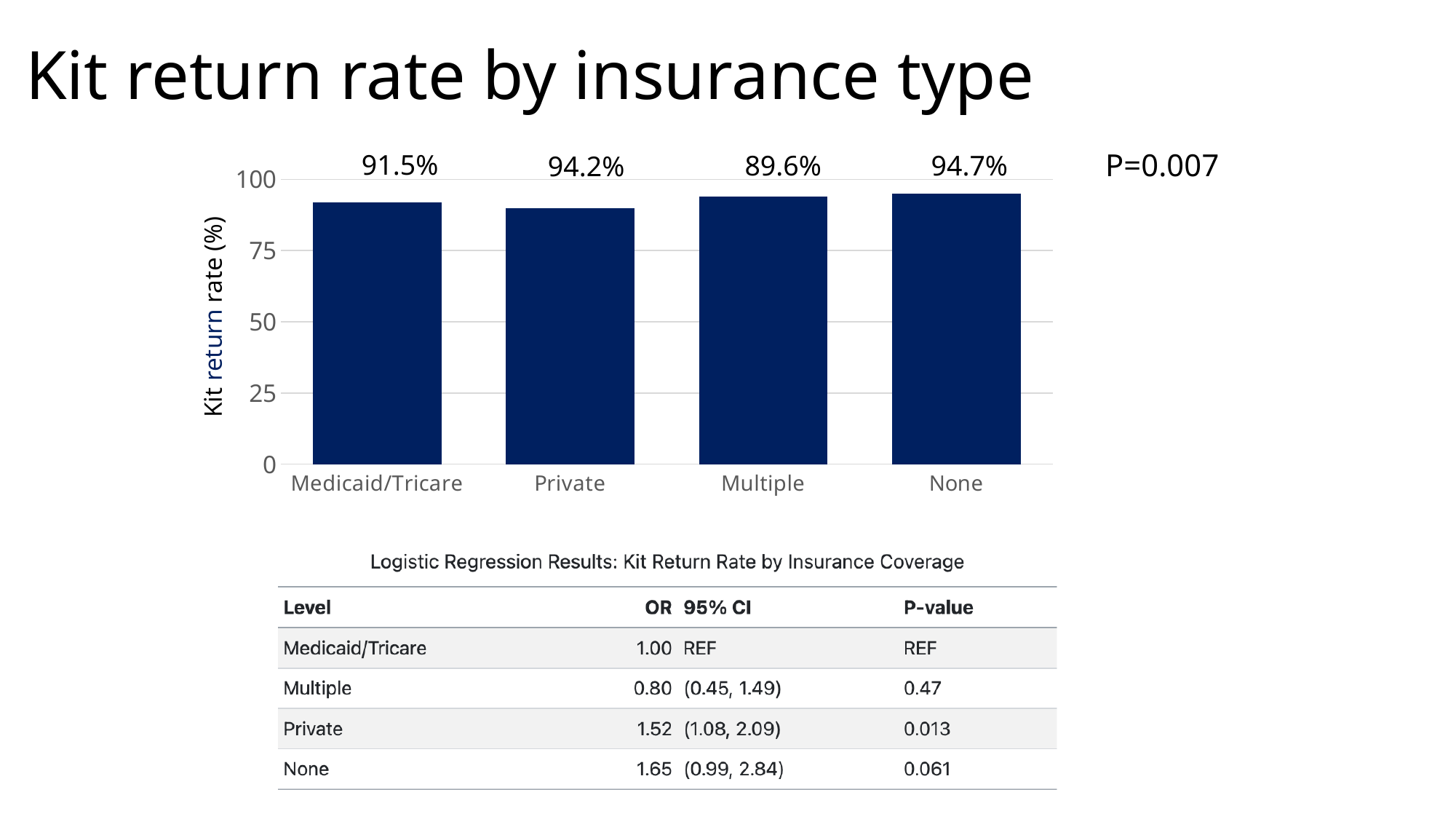
What is the difference between the kit return rate for None and for Medicaid/Tricare? 3.2% What P-value is printed next to the chart? P=0.007 Is the kit return rate for Medicaid/Tricare greater or less than 75? greater Which insurance type has the highest kit return rate? None What is the kit return rate for the None insurance category? 94.7% What is the label on the y axis of the chart? Kit return rate (%) What is the kit return rate for Medicaid/Tricare? 91.5% What kind of chart is shown on the slide? bar chart Which has a higher kit return rate, None or Medicaid/Tricare? None How many insurance type categories are shown on the x axis of the chart? 4 Is the kit return rate for None greater or less than 50? greater